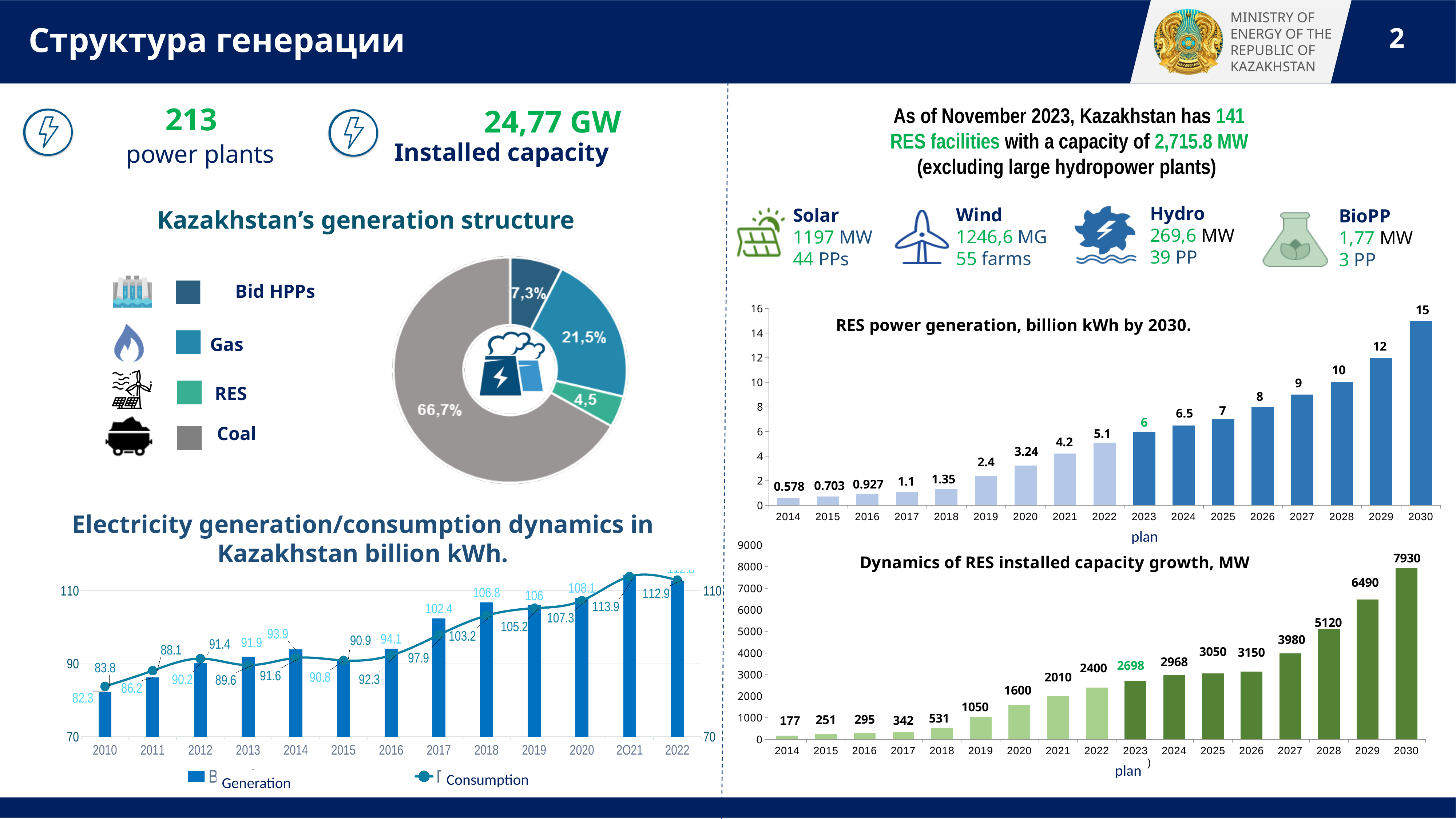
In the 'RES power generation, billion kWh by 2030' chart, what is the value for 2030? 15 In the 'Kazakhstan's generation structure' pie chart, what share does Coal have? 66,7% In the 'RES power generation, billion kWh by 2030' chart, how many years are plotted? 17 In the 'RES power generation, billion kWh by 2030' chart, what is the value for 2014? 0.578 In the 'Kazakhstan's generation structure' pie chart, what is the value shown for Gas? 21,5% In the 'Dynamics of RES installed capacity growth, MW' chart, what is the value for 2023 plan? 2698 How many series does the legend of the 'Electricity generation/consumption dynamics in Kazakhstan billion kWh' chart list? 2 In the 'Dynamics of RES installed capacity growth, MW' chart, what is the difference between the 2030 value and the 2029 value? 1440 In the 'Dynamics of RES installed capacity growth, MW' chart, do the values rise or fall from 2014 to 2030? rise In the 'Kazakhstan's generation structure' pie chart, which category has the smallest share? RES In the 'RES power generation, billion kWh by 2030' chart, what is the difference between the 2030 value and the 2022 value? 9.9 In the 'Kazakhstan's generation structure' pie chart, which category has the largest share? Coal